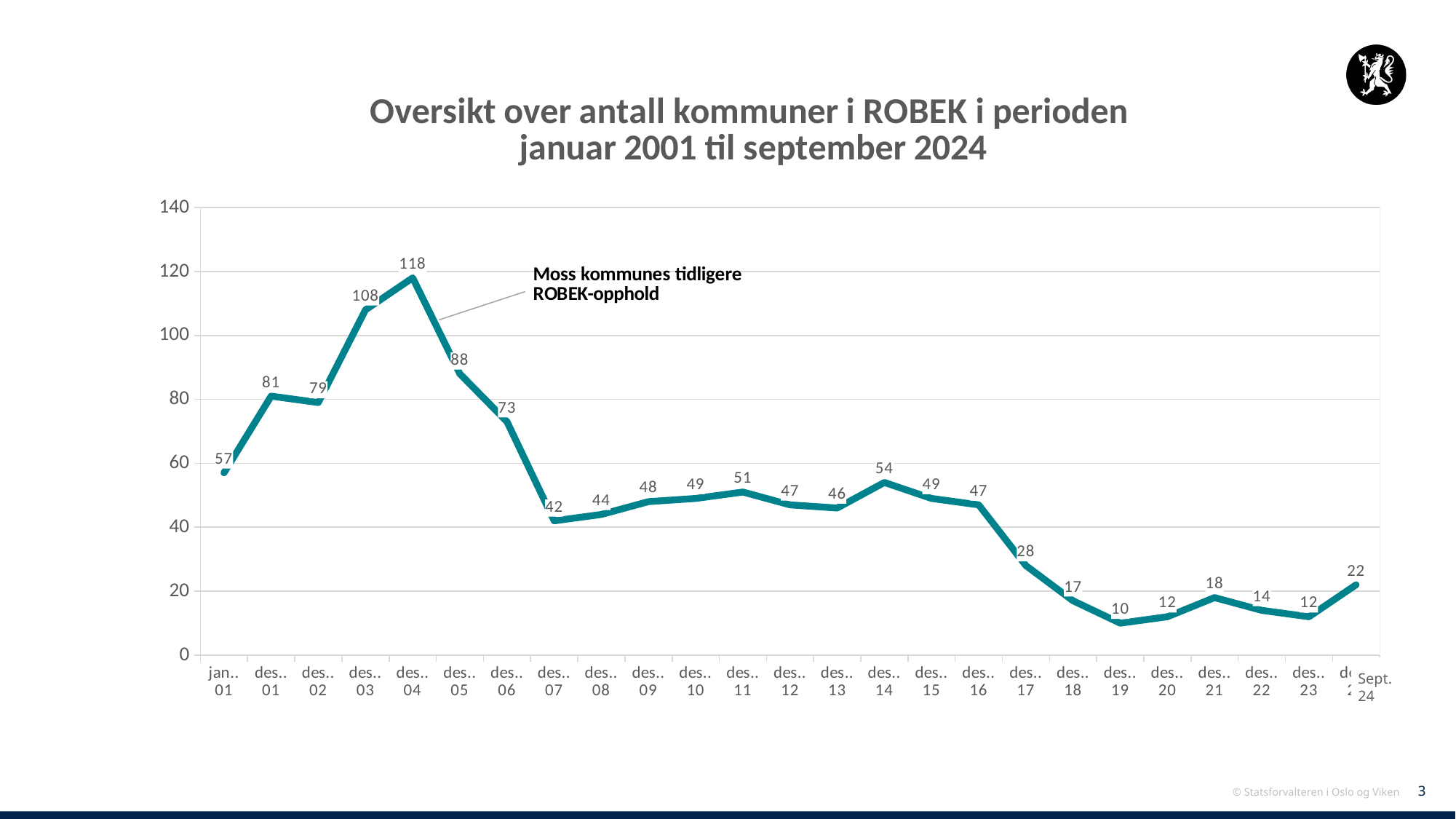
Do the values rise or fall from des 14 to des 19? fall What does the annotation pointing at the line between des 04 and des 05 say? Moss kommunes tidligere ROBEK-opphold Which is larger, the value for des 01 or the value for des 02? des 01 What is the value for jan 01? 57 What kind of chart is shown on the slide? line chart Which point has the highest value? des 04 What is the value for Sept. 24? 22 What is the difference between the values for des 04 and jan 01? 61 Is the value for des 03 greater or less than 100? greater What is the value for des 04? 118 Which point has the lowest value? des 19 What is the value for des 17? 28